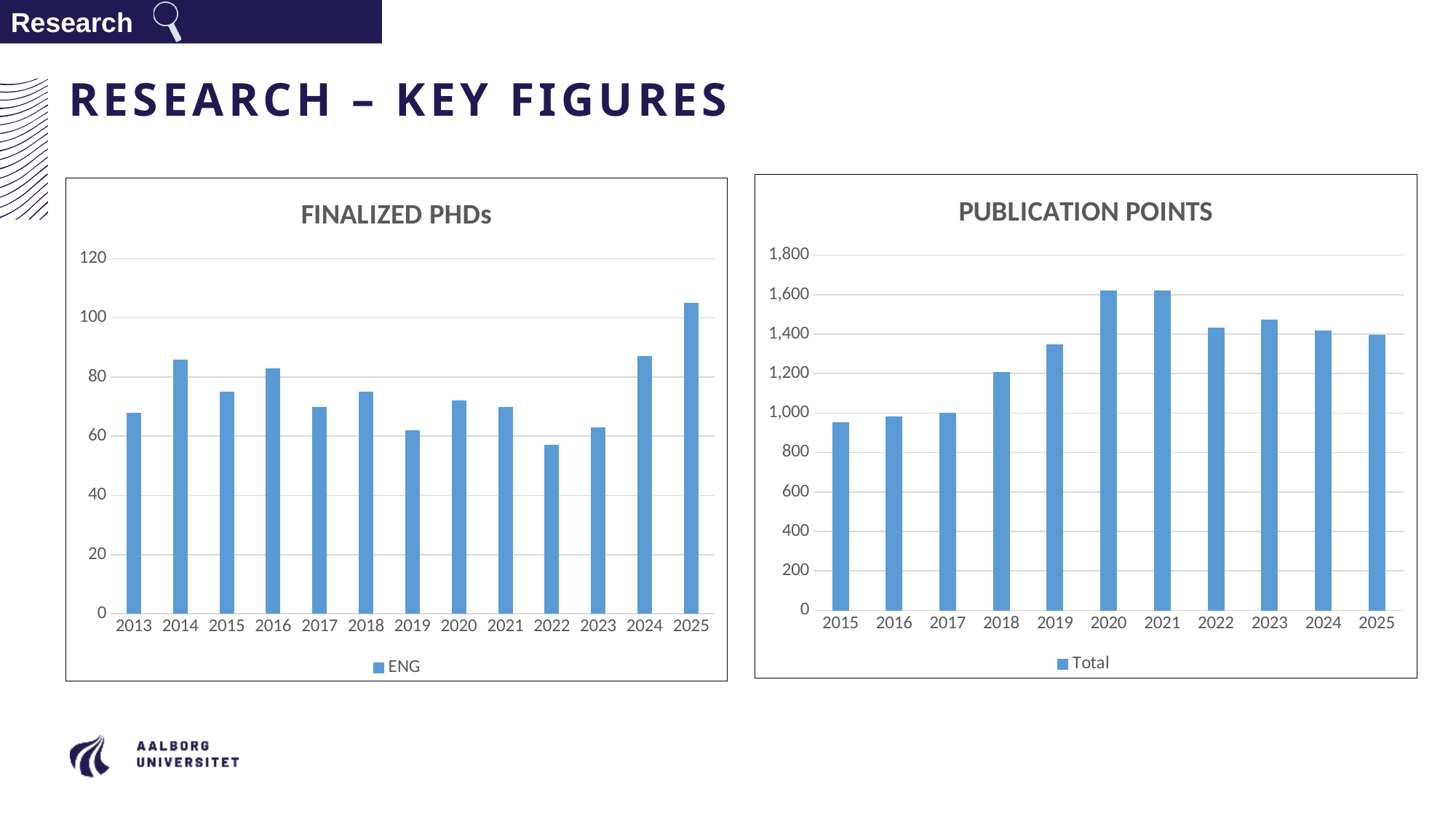
On the FINALIZED PHDs chart, which year has the highest value? 2025 How many years are shown on the FINALIZED PHDs chart? 13 On the PUBLICATION POINTS chart, which is larger, the value for 2018 or the value for 2019? 2019 What kind of chart is the PUBLICATION POINTS chart? bar chart On the FINALIZED PHDs chart, is the value for 2025 greater or less than 100? greater On the FINALIZED PHDs chart, which year has the lowest value? 2022 On the FINALIZED PHDs chart, is the value for 2013 greater or less than 80? less On the PUBLICATION POINTS chart, which year has the lowest value? 2015 On the PUBLICATION POINTS chart, is the value for 2019 greater or less than 1,200? greater What is the legend entry on the PUBLICATION POINTS chart? Total On the FINALIZED PHDs chart, which is larger, the value for 2014 or the value for 2017? 2014